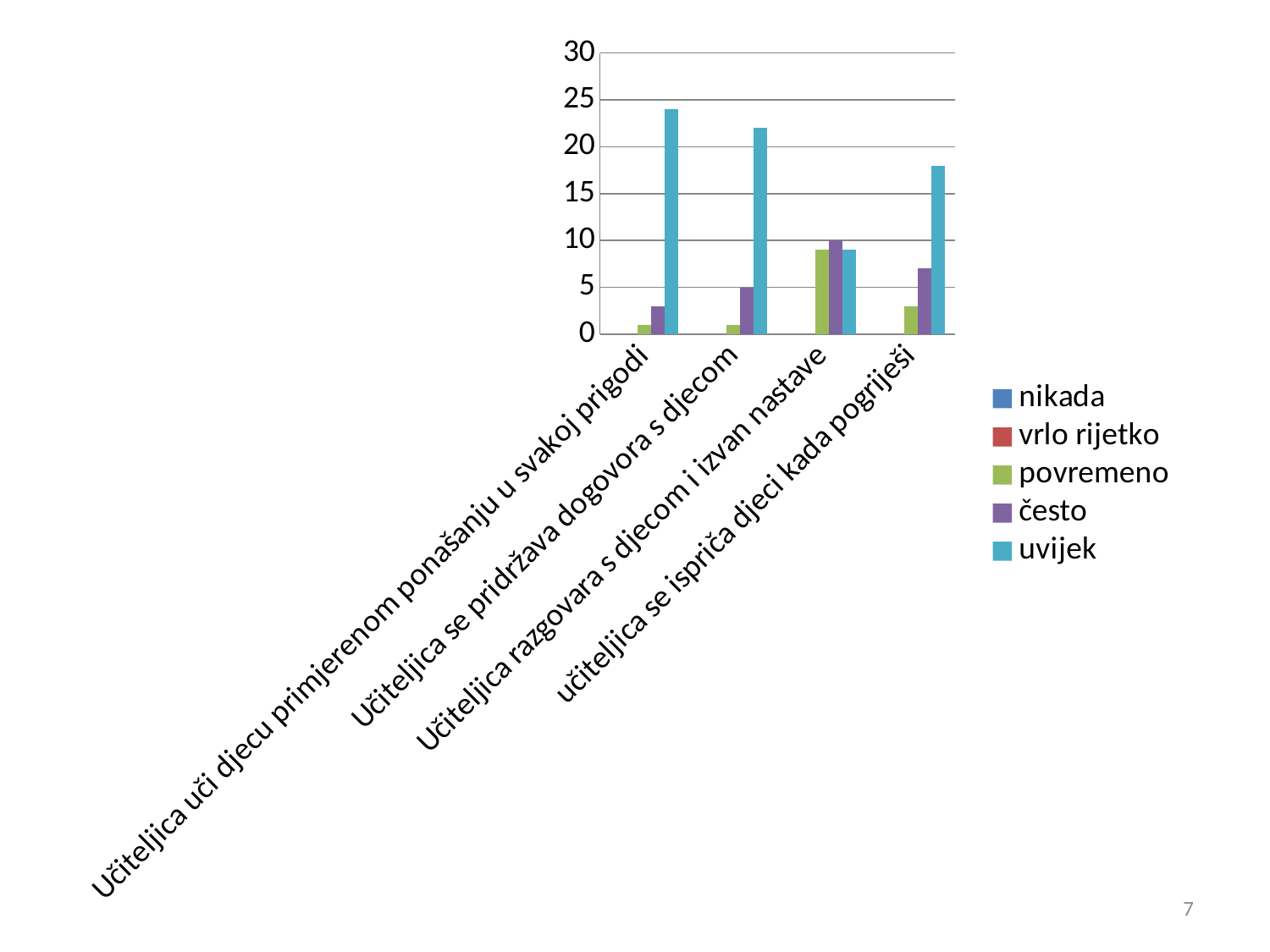
Which series is shown in light blue in the legend? uvijek For 'učiteljica se ispriča djeci kada pogriješi', which is larger: 'često' or 'povremeno'? često What kind of chart is shown on the slide? bar chart What is the value of 'često' for 'Učiteljica se pridržava dogovora s djecom'? 5 Is the value of 'povremeno' for 'Učiteljica razgovara s djecom i izvan nastave' greater or less than 5? greater How many series does the legend list? 5 Is the value of 'uvijek' for 'Učiteljica uči djecu primjerenom ponašanju u svakoj prigodi' greater or less than 20? greater How many categories are shown along the x axis? 4 What is the value of 'često' for 'Učiteljica razgovara s djecom i izvan nastave'? 10 Is the value of 'uvijek' for 'učiteljica se ispriča djeci kada pogriješi' greater or less than 20? less For which category is the 'uvijek' bar the highest? Učiteljica uči djecu primjerenom ponašanju u svakoj prigodi